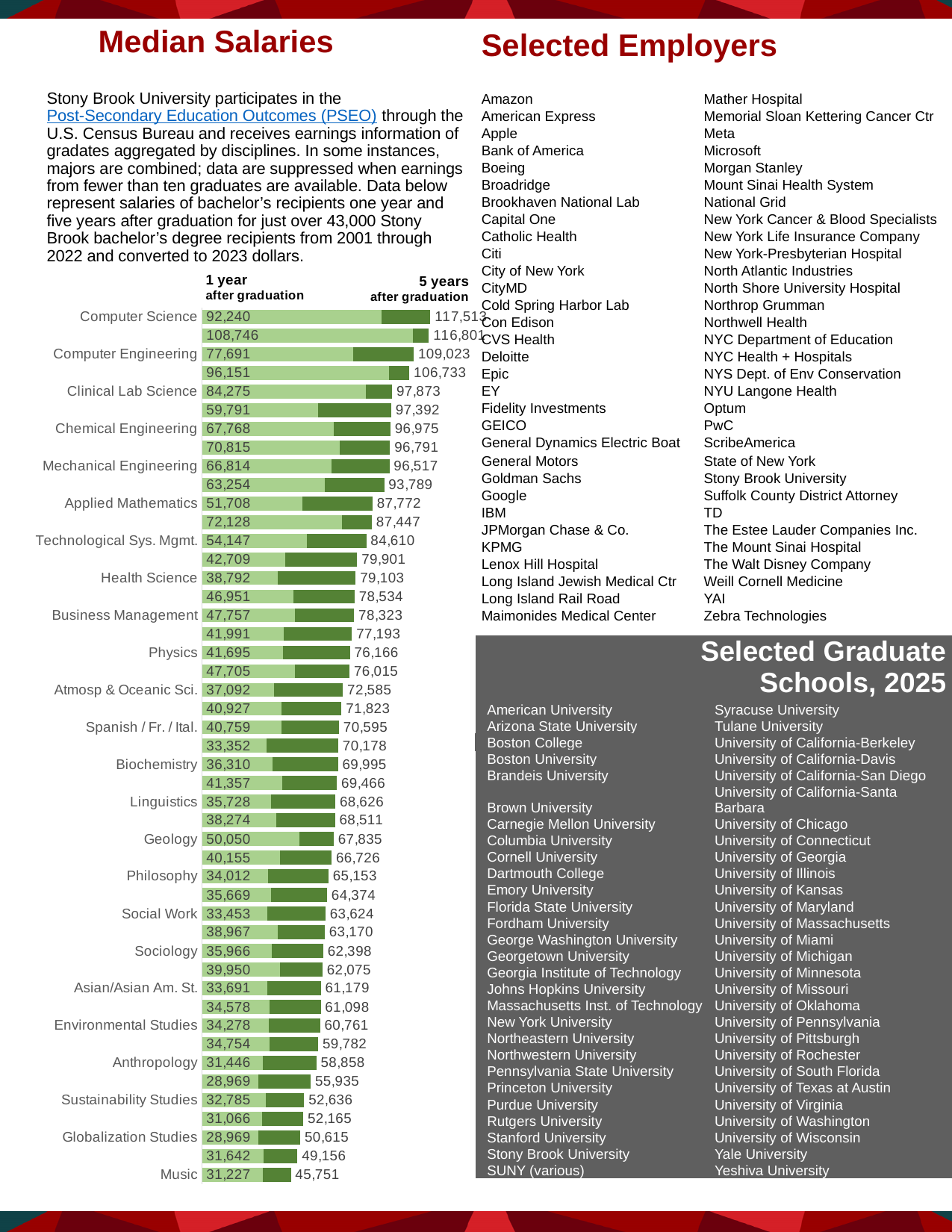
How much higher is the Music median salary five years after graduation than one year after graduation? 14,524 What is the median salary for Music one year after graduation? 31,227 Which discipline has the lowest median salary five years after graduation? Music How much higher is the Computer Science median salary five years after graduation than one year after graduation? 25,273 How many series does the median salaries chart show? 2 What is the median salary for Geology one year after graduation? 50,050 What is the median salary for Computer Science five years after graduation? 117,513 Do the five-year median salaries increase or decrease going down the chart from Computer Science to Music? Decrease What is the median salary for Anthropology five years after graduation? 58,858 Which has the higher median salary five years after graduation, Physics or Health Science? Health Science Which discipline has the highest median salary five years after graduation? Computer Science What type of chart is used to show the median salaries? Bar chart